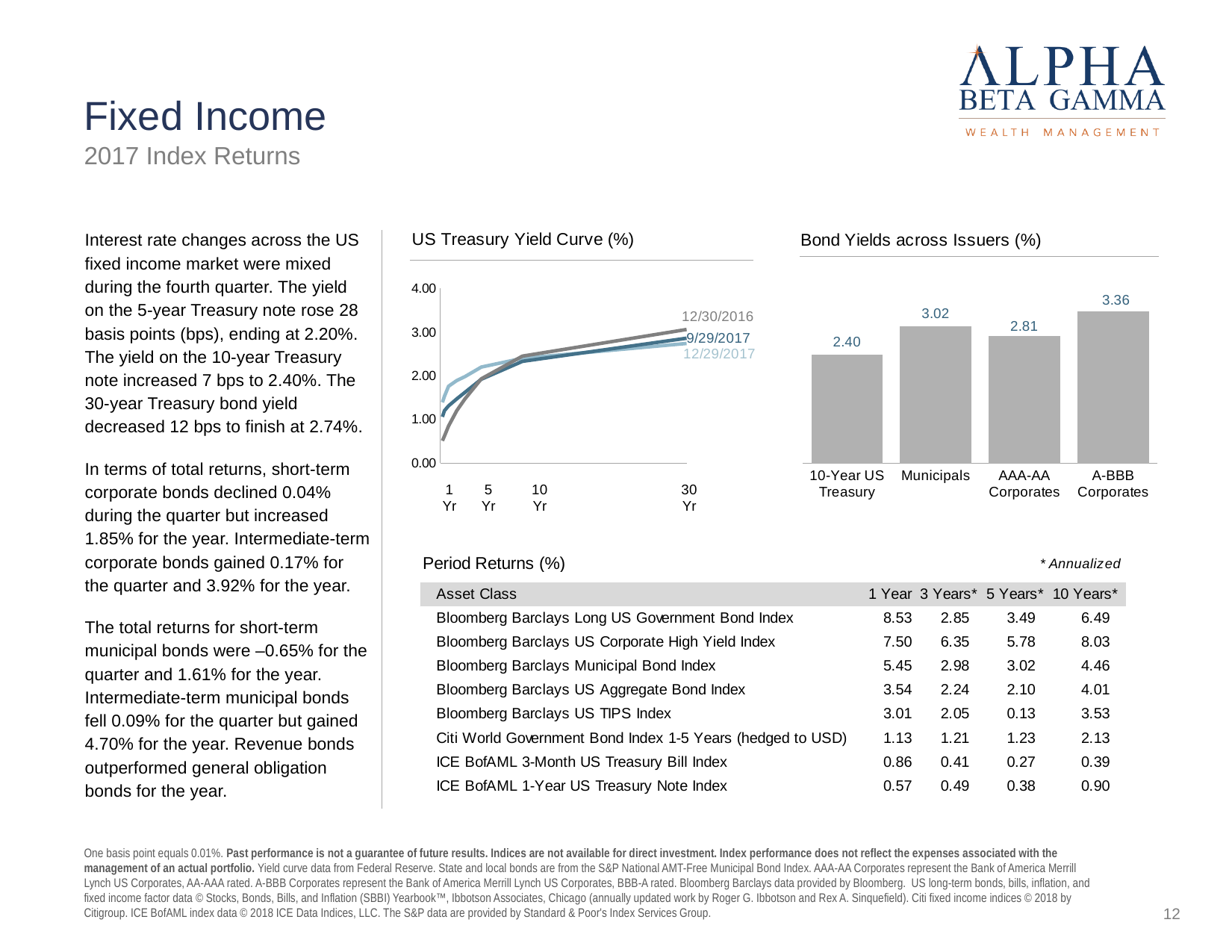
In the Bond Yields across Issuers chart, what is the yield for AAA-AA Corporates? 2.81 In the Bond Yields across Issuers chart, what is the difference between the yields of A-BBB Corporates and AAA-AA Corporates? 0.55 How many series are shown in the US Treasury Yield Curve chart? 3 In the Bond Yields across Issuers chart, which has the higher yield, Municipals or AAA-AA Corporates? Municipals In the US Treasury Yield Curve chart, do the yields rise or fall as maturity increases from 1 Yr to 30 Yr? Rise In the Bond Yields across Issuers chart, what is the yield for the 10-Year US Treasury? 2.40 How many issuer categories are shown in the Bond Yields across Issuers chart? 4 In the Bond Yields across Issuers chart, what is the yield for Municipals? 3.02 What type of chart is the Bond Yields across Issuers chart? Bar chart In the US Treasury Yield Curve chart, is the 12/29/2017 value at 30 Yr greater or less than 3.00? less In the Bond Yields across Issuers chart, which issuer has the highest yield? A-BBB Corporates In the Bond Yields across Issuers chart, which issuer has the lowest yield? 10-Year US Treasury